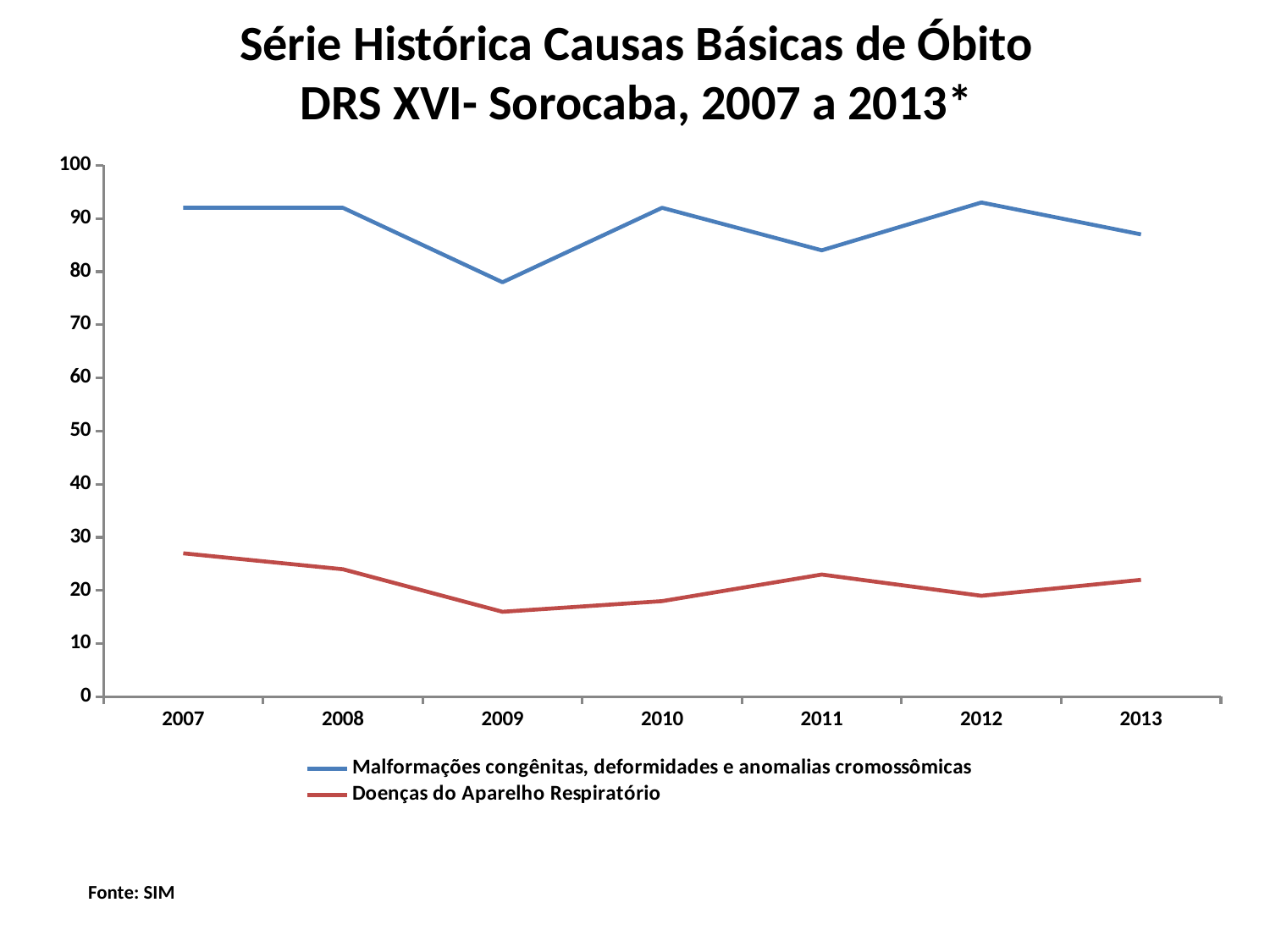
In which year is the value for Doenças do Aparelho Respiratório lowest? 2009 Is the value for Malformações congênitas, deformidades e anomalias cromossômicas in 2012 greater or less than 90? greater How many years are plotted along the x axis? 7 In which year is the value for Malformações congênitas, deformidades e anomalias cromossômicas lowest? 2009 In which year is the value for Doenças do Aparelho Respiratório highest? 2007 Which year has the larger value for Malformações congênitas, deformidades e anomalias cromossômicas, 2010 or 2011? 2010 Does the value for Doenças do Aparelho Respiratório rise or fall from 2007 to 2009? Fall What kind of chart is shown on the slide? Line chart Is the value for Malformações congênitas, deformidades e anomalias cromossômicas in 2009 greater or less than 80? less What colour is the line for Doenças do Aparelho Respiratório? Red Is the value for Doenças do Aparelho Respiratório in 2007 greater or less than 30? less How many series does the legend list? 2